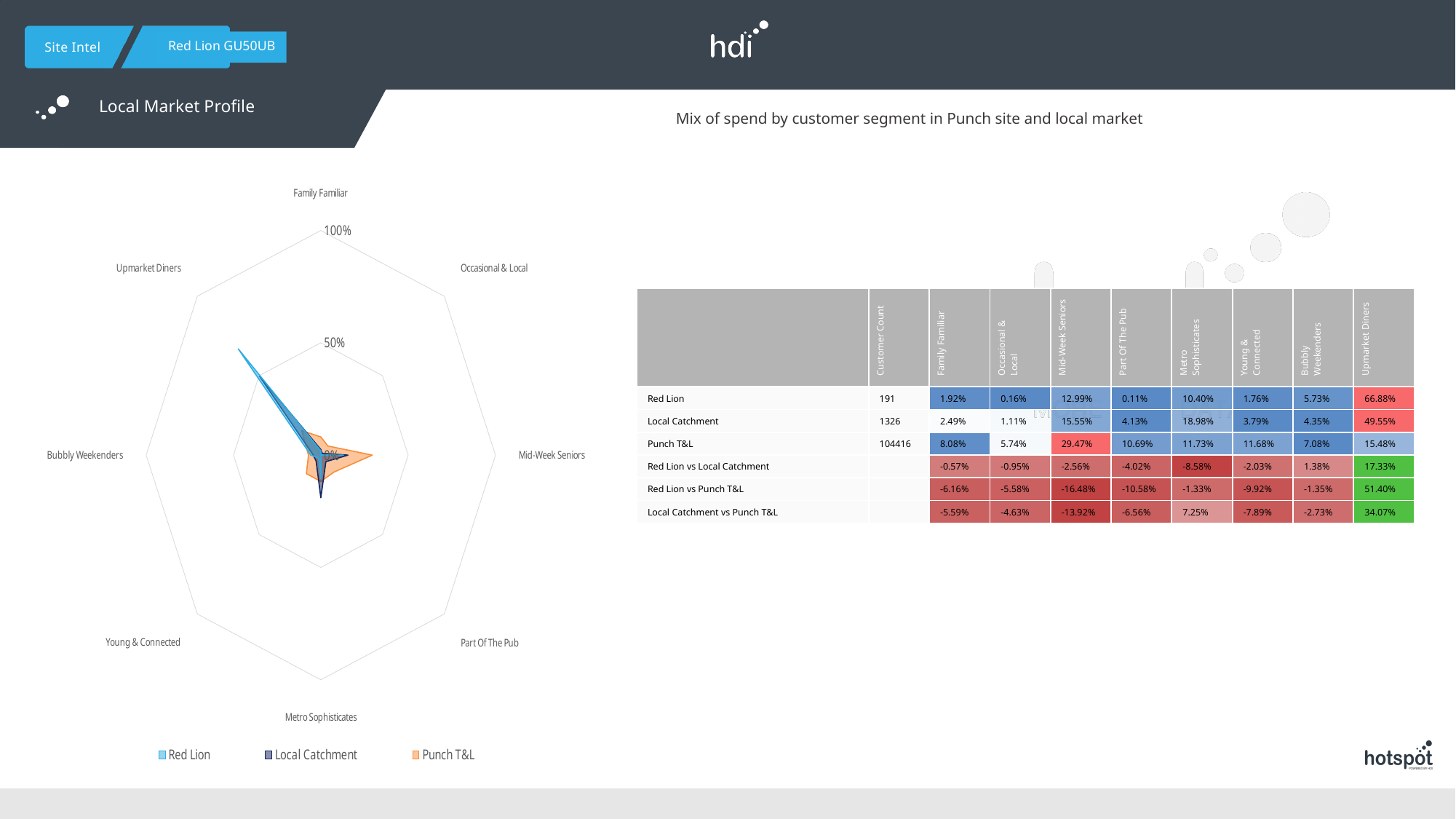
What is the difference between the Red Lion and Local Catchment values for Upmarket Diners? 17.33% In the radar chart, which category has the highest value for the Punch T&L series? Mid-Week Seniors In the radar chart, is the Punch T&L value for Mid-Week Seniors greater or less than 50%? less How many customer segment categories does the radar chart plot? 8 What is the highest value shown on the radar chart's axis scale? 100% What is the Red Lion value for Upmarket Diners, as printed in the table? 66.88% In the radar chart, which category has the highest value for the Red Lion series? Upmarket Diners How many series does the radar chart's legend list? 3 For Upmarket Diners, which series is larger: Red Lion or Punch T&L? Red Lion What kind of chart is shown on the left of the slide? Radar chart In the radar chart, is the Red Lion value for Upmarket Diners greater or less than 50%? greater What are the three series named in the radar chart's legend? Red Lion, Local Catchment, Punch T&L